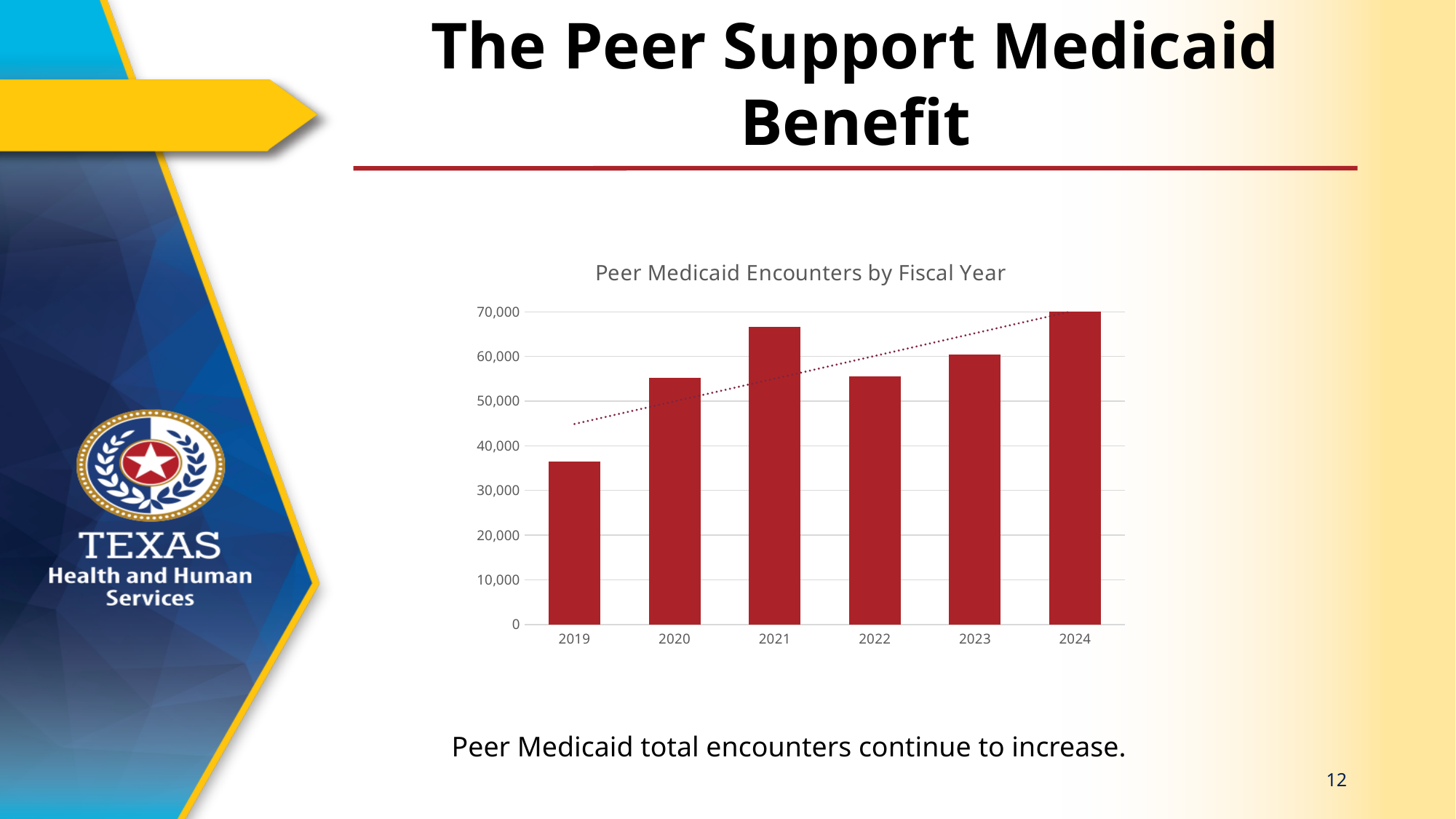
Which fiscal year has more encounters, 2020 or 2023? 2023 How many fiscal years are shown on the x axis of the chart? 6 Is the value for 2023 greater or less than 50,000? greater Which fiscal year has the lowest number of Peer Medicaid encounters? 2019 Which fiscal year has more encounters, 2021 or 2022? 2021 What is the title of the chart? Peer Medicaid Encounters by Fiscal Year What type of chart is shown on the slide? Bar chart Is the value for 2021 greater or less than 60,000? greater Is the value for 2019 greater or less than 40,000? less Which fiscal year has the highest number of Peer Medicaid encounters? 2024 Do Peer Medicaid encounters generally rise or fall from 2019 to 2024? Rise